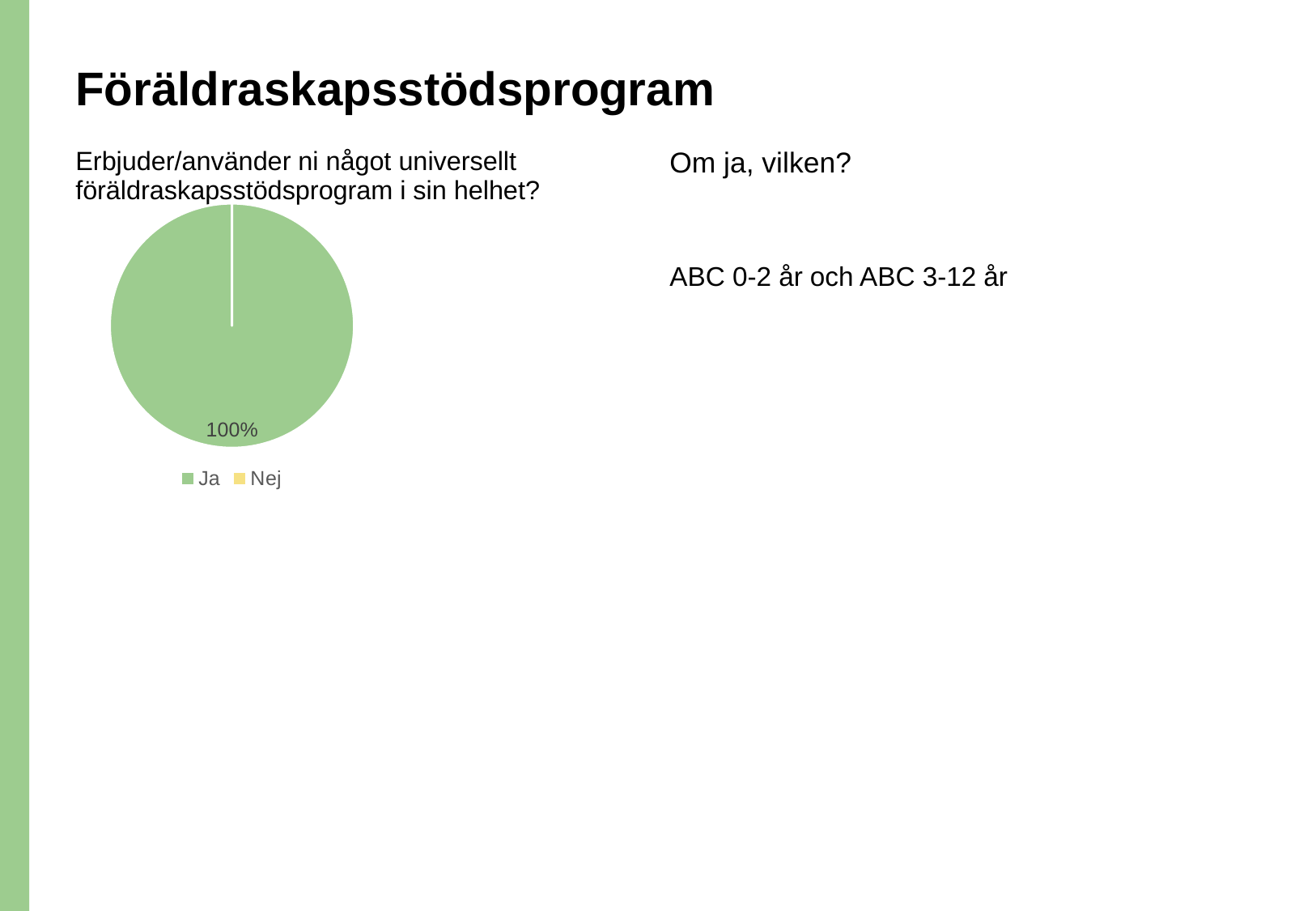
Is the share for "Ja" greater or less than 50%? greater What value is printed on the pie chart? 100% Which is larger, the share for "Ja" or the share for "Nej"? Ja Which category is shown in green in the legend? Ja Which two categories are listed in the legend? Ja and Nej How many entries does the legend list? 2 Which category has the largest share of the pie? Ja What share of the pie does "Ja" account for? 100% What kind of chart is shown on the slide? pie chart